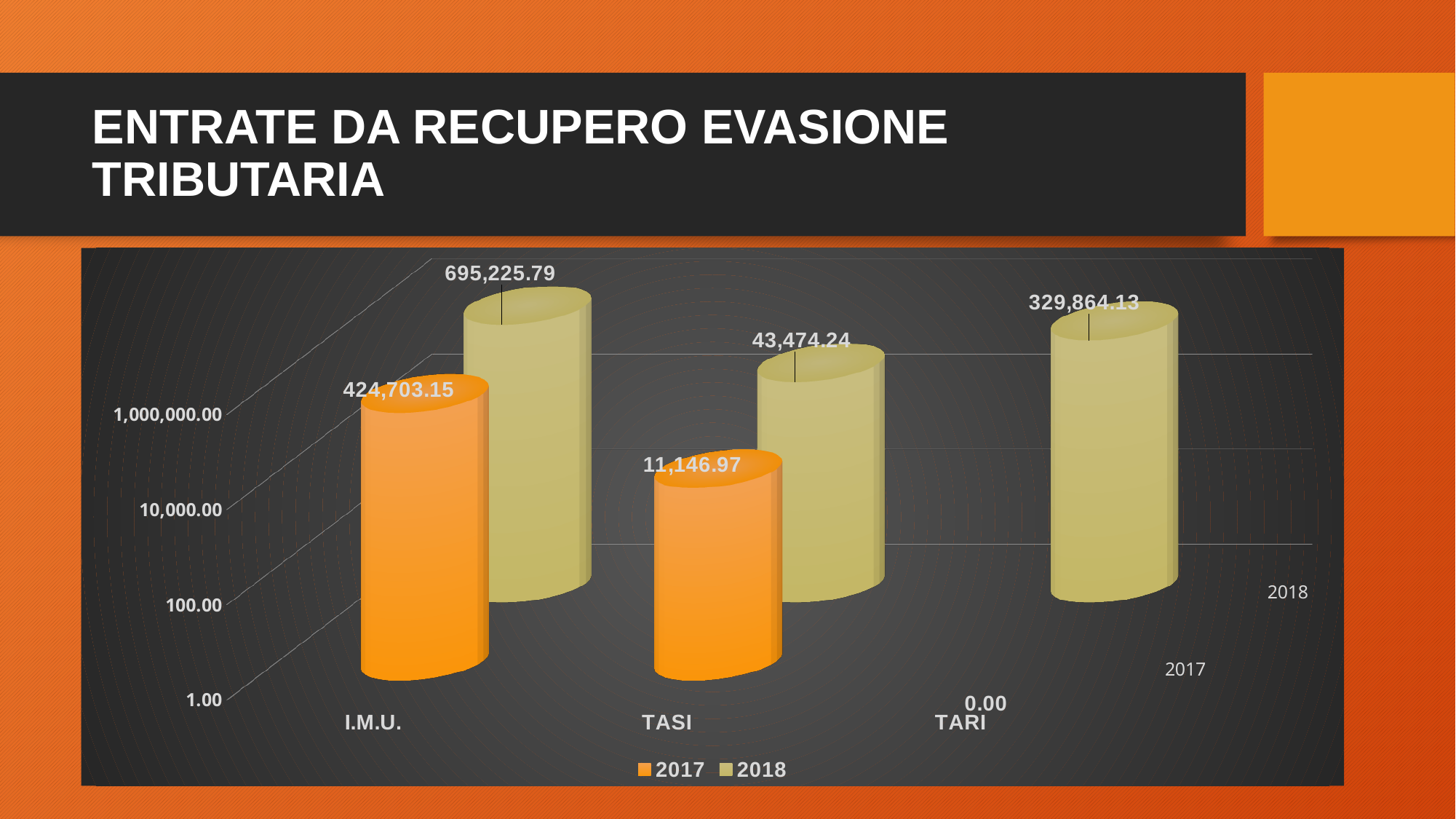
Which category has the lowest value in the 2017 series? TARI What is the value for I.M.U. in the 2018 series? 695,225.79 Which category has the highest value in the 2018 series? I.M.U. What is the difference between the 2018 and 2017 values for I.M.U.? 270,522.64 What is the difference between the 2018 and 2017 values for TASI? 32,327.27 What is the value for TARI in the 2017 series? 0.00 Which is larger for TASI: the 2017 value or the 2018 value? 2018 What is the value for TASI in the 2017 series? 11,146.97 How many series does the legend list? 2 What is the value for TARI in the 2018 series? 329,864.13 What kind of chart is shown on the slide? Bar chart How many categories are shown on the x axis? 3